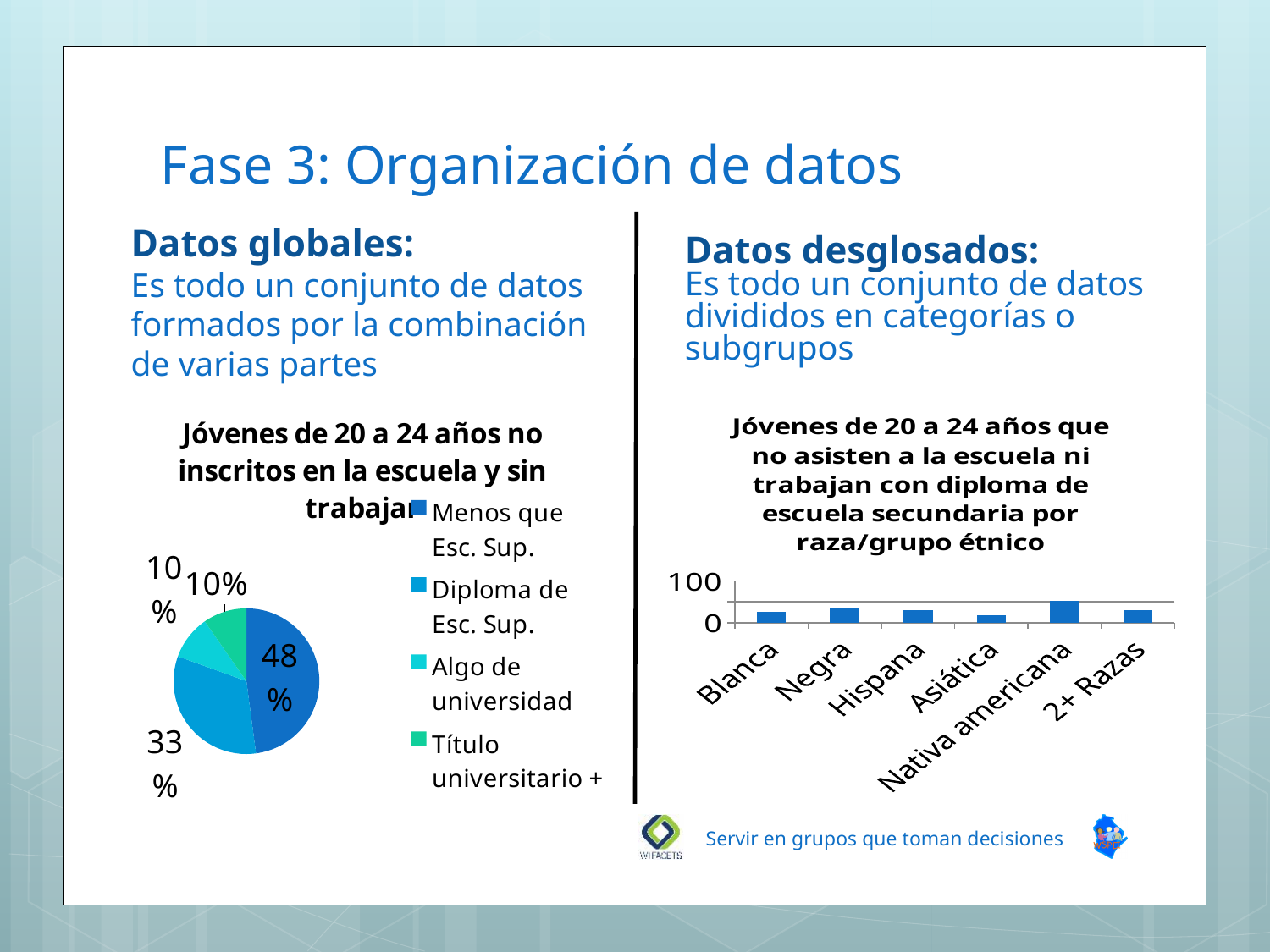
How many racial/ethnic categories are shown on the x axis of the bar chart on the right? 6 In the bar chart on the right, which category has the lowest bar? Asiática In the pie chart on the left, which legend category has the largest share? Menos que Esc. Sup. What type of chart is shown on the right side of the slide? Bar chart In the pie chart on the left, what percentage is shown for the largest slice? 48% In the pie chart on the left, what percentage is shown for 'Algo de universidad'? 10% In the pie chart on the left, what is the difference between the 48% slice and the 33% slice? 15% In the bar chart on the right, which category has the highest bar? Nativa americana In the pie chart on the left, what percentage corresponds to 'Diploma de Esc. Sup.'? 33% How many categories does the legend of the pie chart on the left list? 4 What type of chart is shown on the left side of the slide? Pie chart In the bar chart on the right, is the value for Asiática greater or less than 50? less